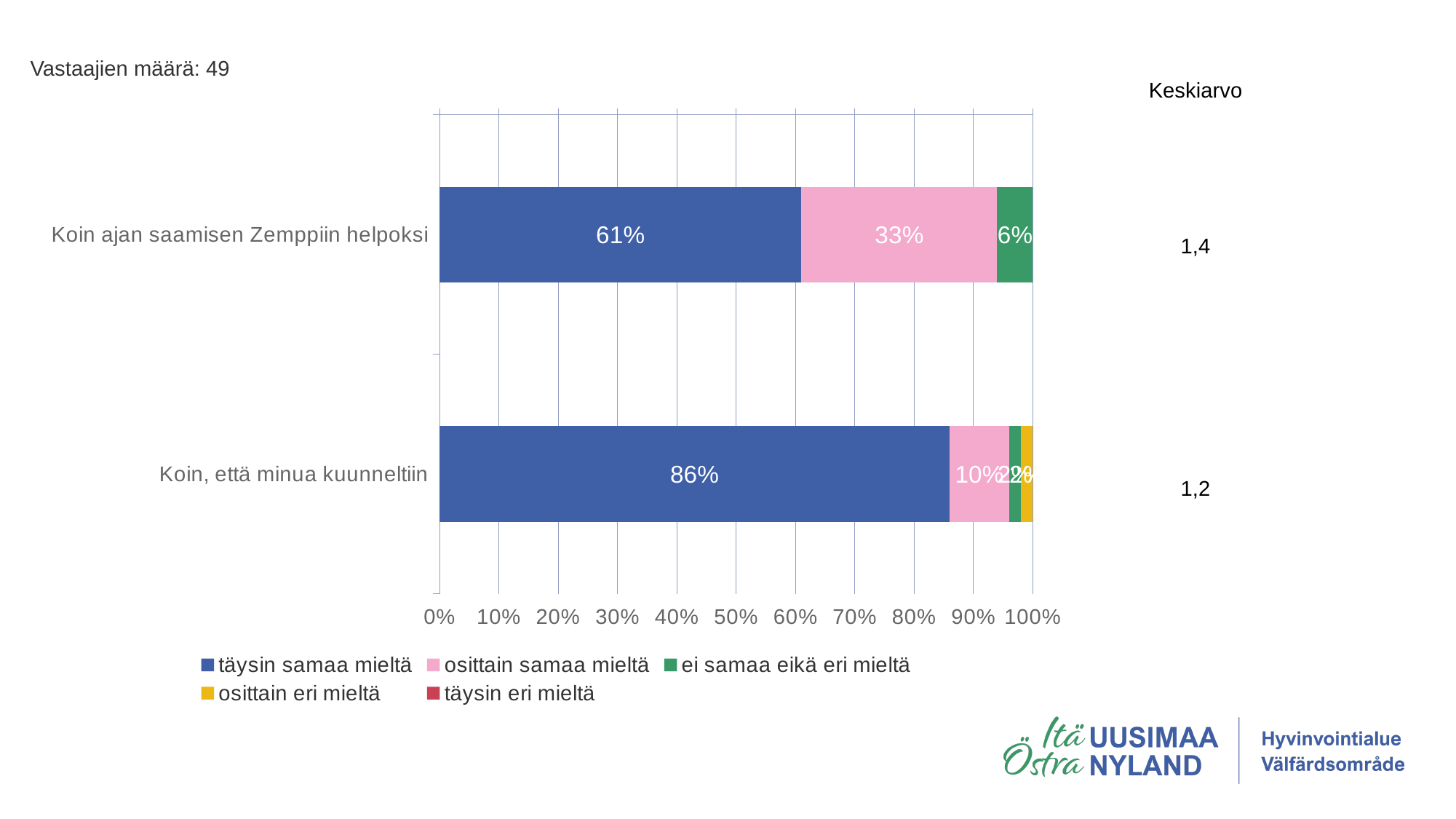
How many categories (statements) are plotted on the chart? 2 What is the Keskiarvo (mean) shown for 'Koin ajan saamisen Zemppiin helpoksi'? 1,4 What is the difference between the 'täysin samaa mieltä' shares of the two statements? 25 percentage points What is the value of 'ei samaa eikä eri mieltä' for 'Koin ajan saamisen Zemppiin helpoksi'? 6% What is the value of 'täysin samaa mieltä' for 'Koin ajan saamisen Zemppiin helpoksi'? 61% What is the value of 'osittain samaa mieltä' for 'Koin ajan saamisen Zemppiin helpoksi'? 33% How many respondents (Vastaajien määrä) does the slide report? 49 What is the value of 'osittain samaa mieltä' for 'Koin, että minua kuunneltiin'? 10% What kind of chart is shown on the slide? stacked bar chart Which statement has the higher share of 'täysin samaa mieltä'? Koin, että minua kuunneltiin How many series does the legend list? 5 What is the value of 'täysin samaa mieltä' for 'Koin, että minua kuunneltiin'? 86%